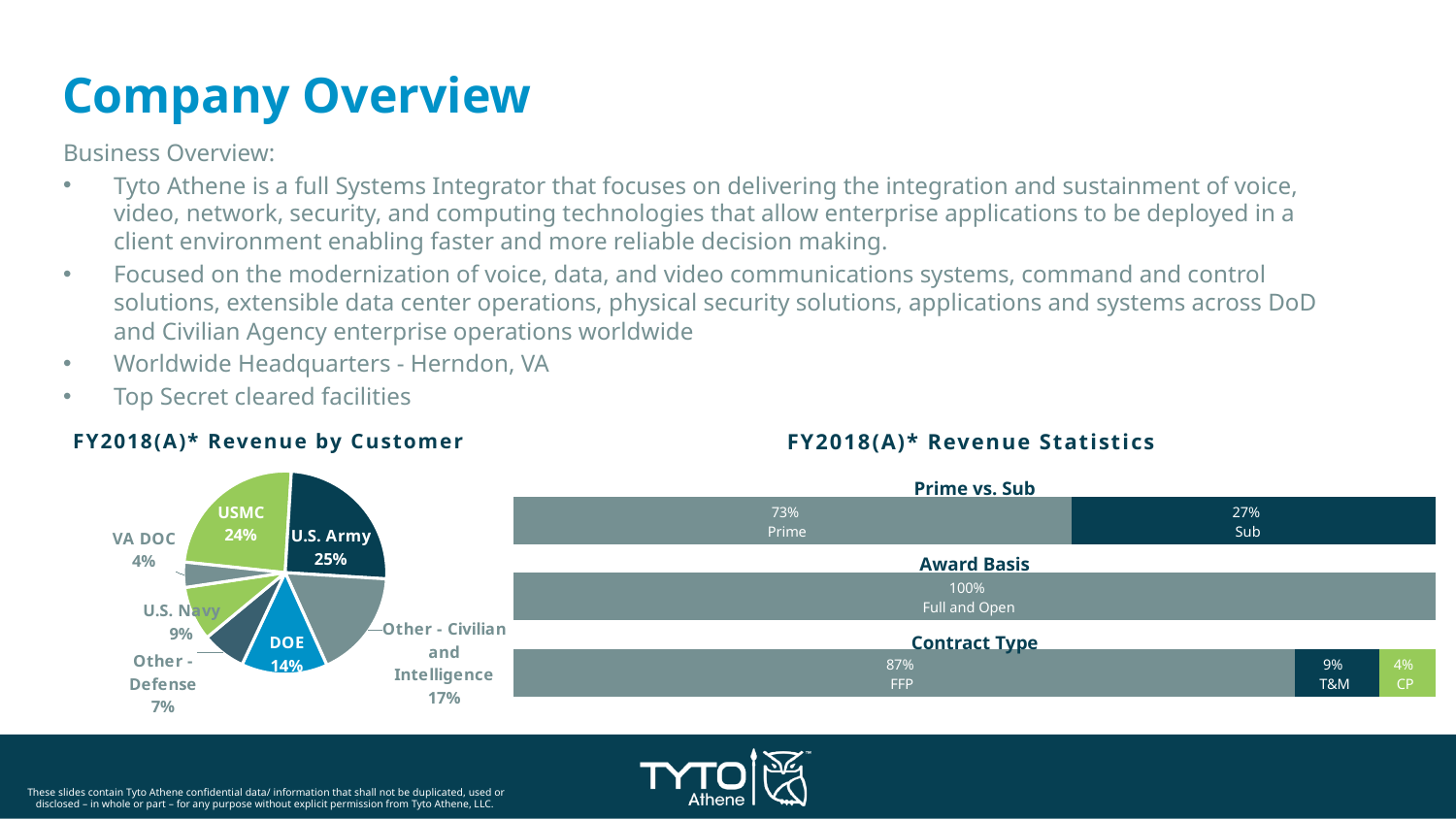
In the FY2018(A)* Revenue by Customer chart, which is larger, the share for Other - Civilian and Intelligence or the share for Other - Defense? Other - Civilian and Intelligence In the FY2018(A)* Revenue Statistics chart, what is the difference between the FFP share and the CP share in the Contract Type bar? 83% In the FY2018(A)* Revenue Statistics chart, what percentage of revenue is T&M in the Contract Type bar? 9% In the FY2018(A)* Revenue Statistics chart, what percentage of revenue is Prime in the Prime vs. Sub bar? 73% What kind of chart is the FY2018(A)* Revenue by Customer chart? Pie chart In the FY2018(A)* Revenue by Customer chart, which customer has the largest share of revenue? U.S. Army In the FY2018(A)* Revenue Statistics chart, what label is shown for the Award Basis bar? 100% Full and Open In the FY2018(A)* Revenue by Customer chart, how many customer categories are shown? 7 In the FY2018(A)* Revenue by Customer chart, what share of revenue comes from U.S. Army? 25% In the FY2018(A)* Revenue by Customer chart, what is the difference between the USMC share and the U.S. Navy share? 15% In the FY2018(A)* Revenue by Customer chart, which customer has the smallest share of revenue? VA DOC In the FY2018(A)* Revenue by Customer chart, what share of revenue comes from DOE? 14%